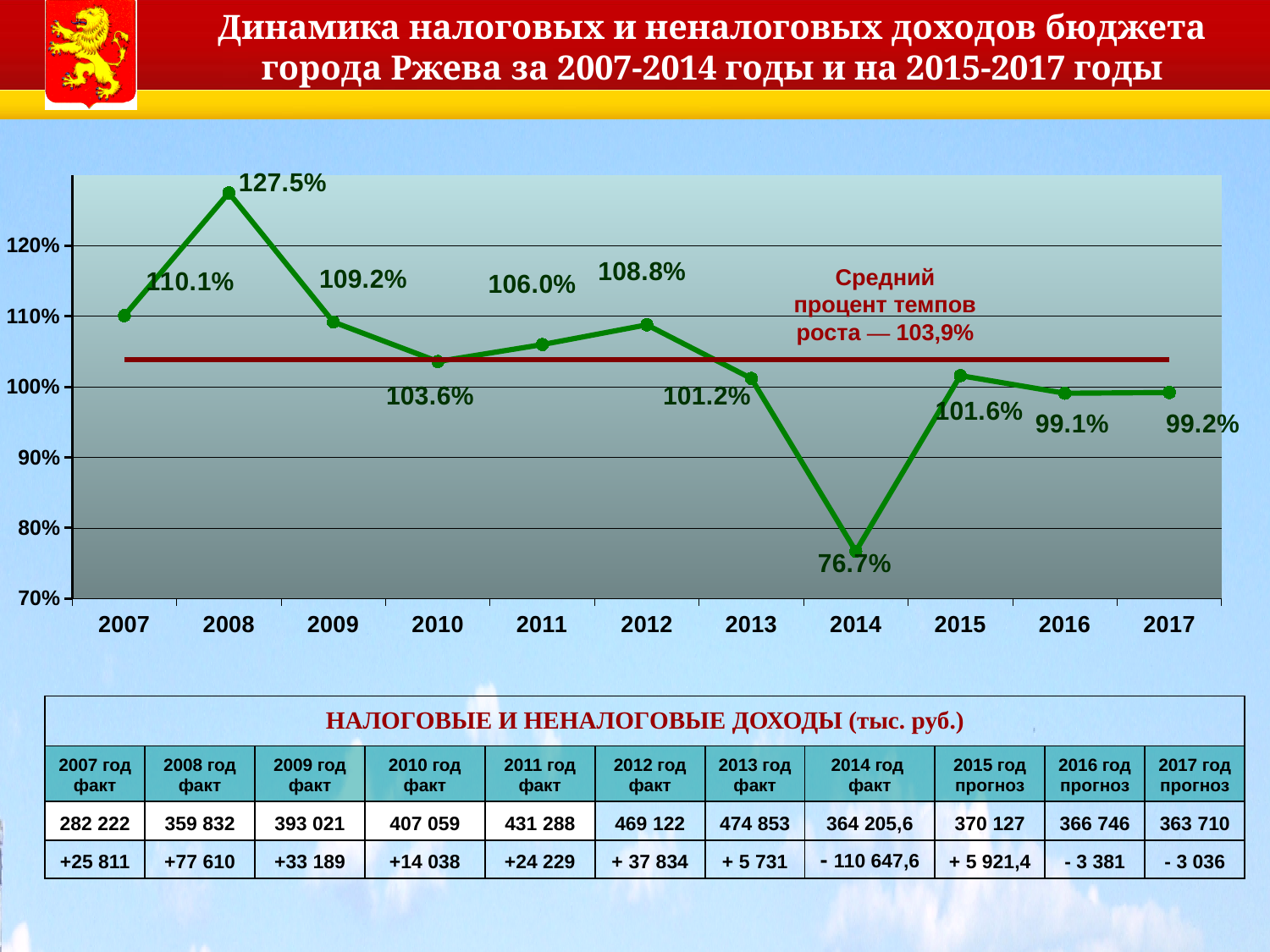
What is the value plotted for 2017? 99.2% What is the difference between the values for 2008 and 2014? 50.8 percentage points What is the value plotted for 2008? 127.5% What value does the horizontal red line on the chart represent? 103,9% (average growth rate) Which is larger, the value for 2012 or the value for 2013? 2012 What type of chart is shown on the slide? line chart Which year has the highest value on the chart? 2008 What is the value plotted for 2011? 106.0% What is the value plotted for 2014? 76.7% Is the value for 2014 greater or less than 80%? less How many years are plotted on the x axis of the chart? 11 Which year has the lowest value on the chart? 2014